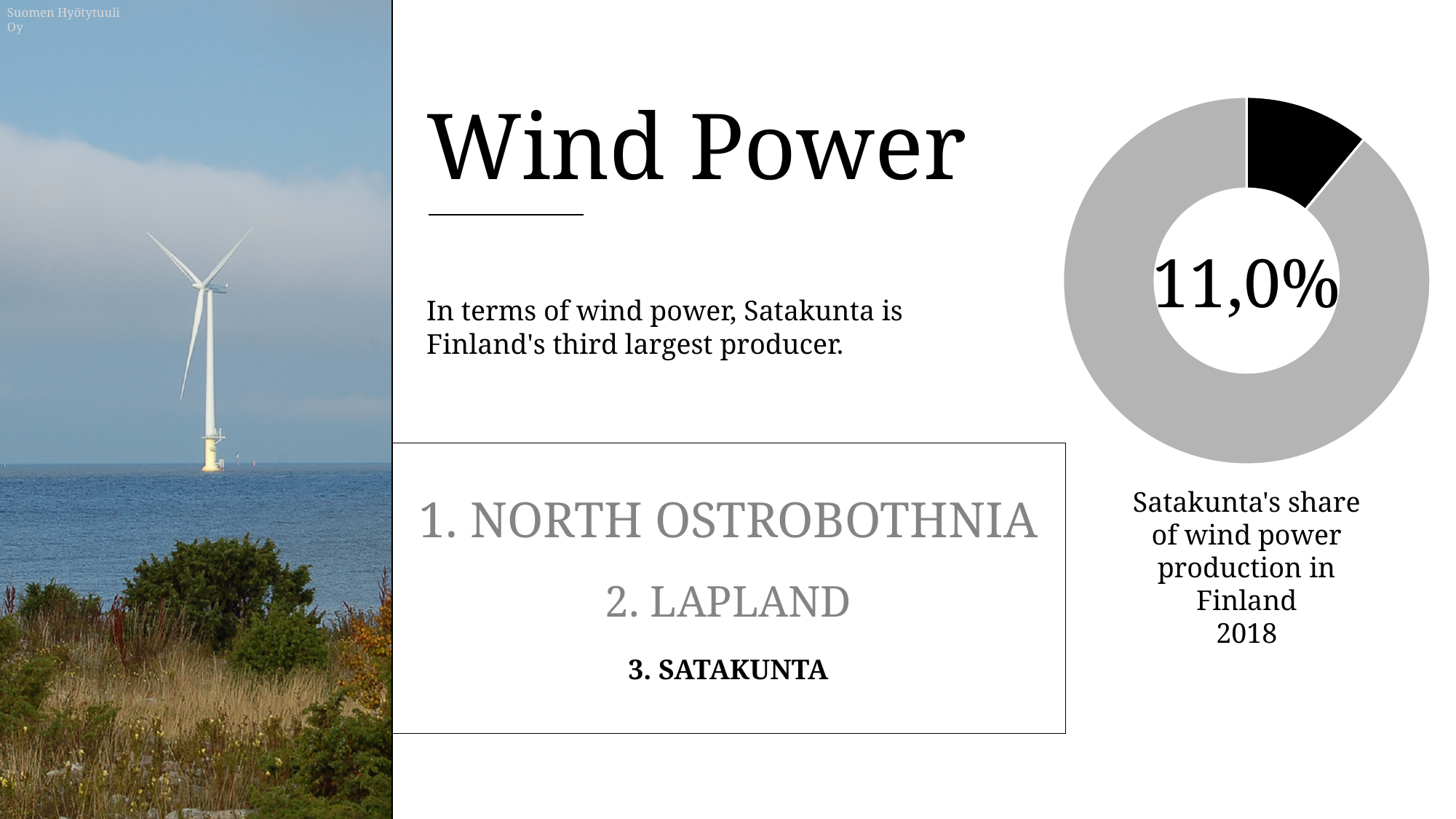
What was Satakunta's share of wind power production in Finland in 2018 according to the chart? 11,0% Is Satakunta's share shown in the donut chart greater or less than 50%? less What value is printed in the centre of the donut chart? 11,0% Which slice of the donut chart is larger, the black one or the grey one? the grey one What share of the donut chart does the grey slice represent? 89,0% Is Satakunta's share shown in the donut chart greater or less than 10%? greater What colour is the slice representing Satakunta's share in the donut chart? black What year does the donut chart's caption refer to? 2018 How many slices does the donut chart have? 2 Which slice of the donut chart is the smallest? the black slice (Satakunta, 11,0%) What kind of chart is shown on the right side of the slide? donut chart